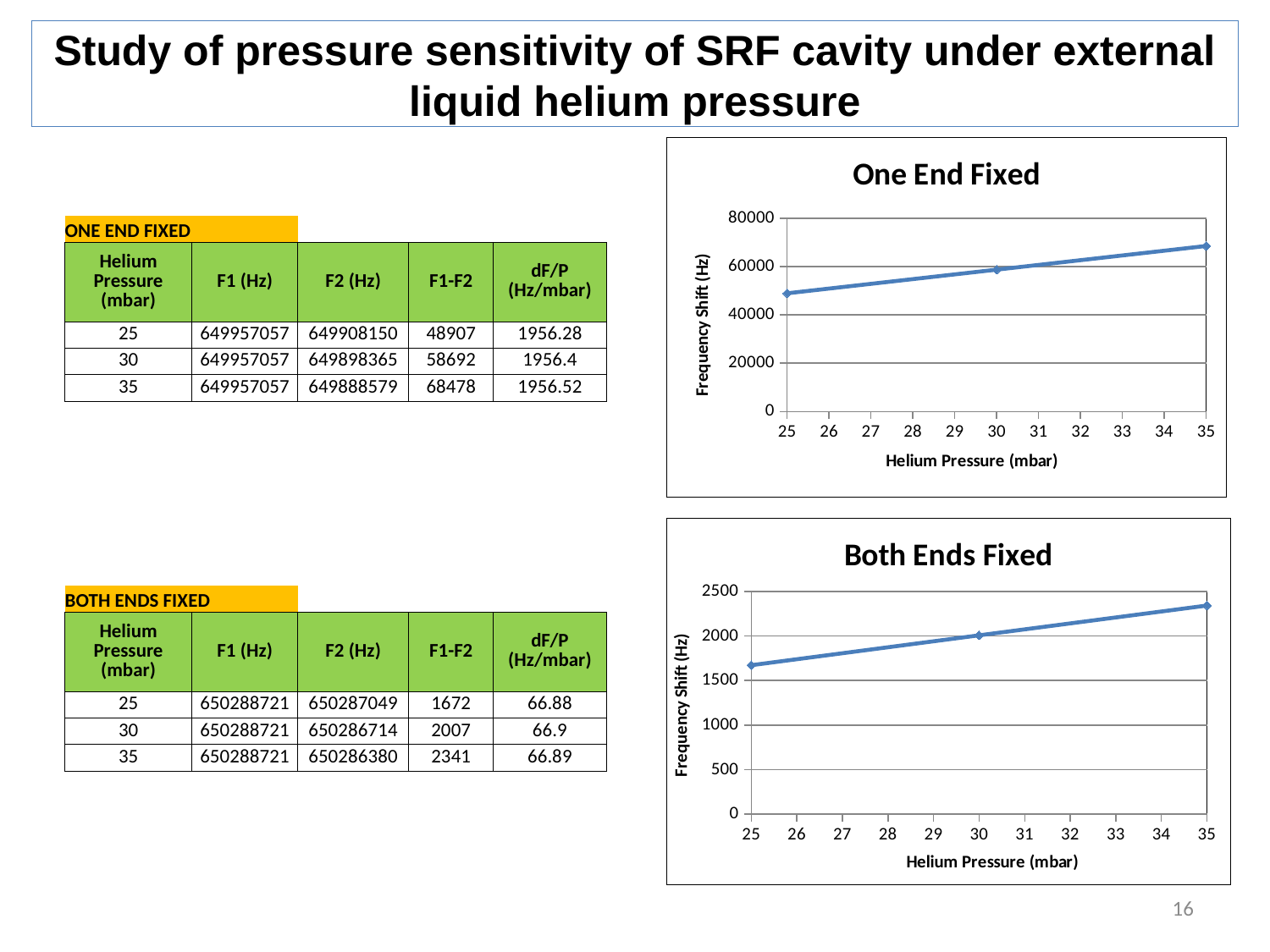
In the "Both Ends Fixed" chart, does the frequency shift rise or fall as helium pressure increases? rise In the "One End Fixed" chart, which helium pressure has the highest frequency shift? 35 What is the y-axis label of the "Both Ends Fixed" chart? Frequency Shift (Hz) In the "Both Ends Fixed" chart, is the frequency shift at 25 mbar greater or less than 2000? less In the "One End Fixed" chart, does the frequency shift rise or fall as helium pressure increases from 25 to 35 mbar? rise How many data points are plotted in the "Both Ends Fixed" chart? 3 In the "Both Ends Fixed" chart, is the frequency shift at 35 mbar greater or less than 2000? greater How many data points are plotted in the "One End Fixed" chart? 3 What kind of chart is the "Both Ends Fixed" chart? line chart What kind of chart is the "One End Fixed" chart? line chart In the "One End Fixed" chart, is the frequency shift at 35 mbar greater or less than 60000? greater